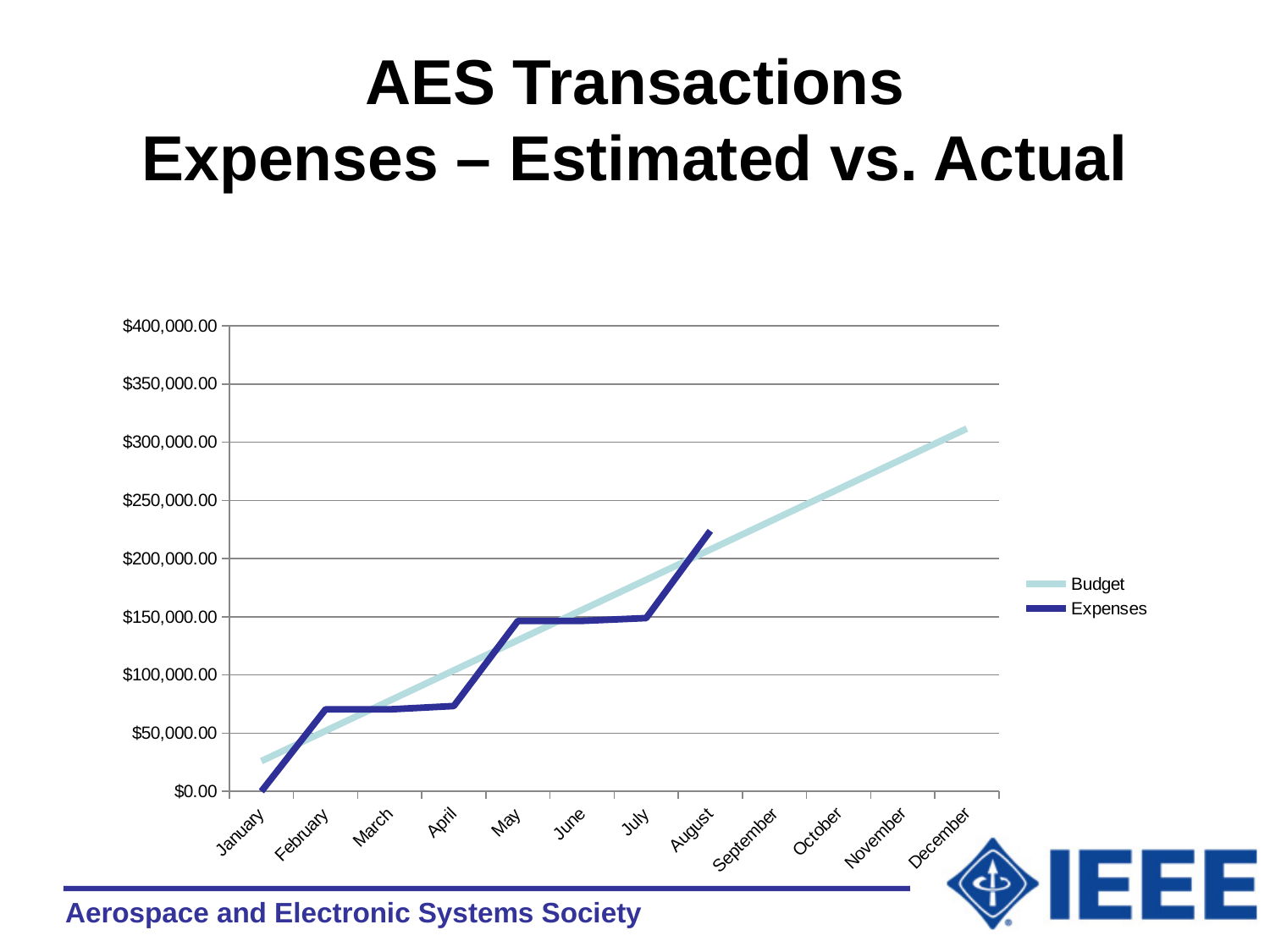
In August, which series is higher, Budget or Expenses? Expenses Is the Budget value for December greater or less than $300,000.00? greater Does the Budget line rise or fall from January to December? rises Is the Expenses value for August greater or less than $200,000.00? greater How many series does the legend list? 2 What kind of chart is shown on the slide? line chart In April, which series is higher, Budget or Expenses? Budget In which month does the Expenses series reach its highest value? August How many months are shown along the x axis? 12 Is the Expenses value for February greater or less than $100,000.00? less What is the last month for which the Expenses series has a plotted value? August